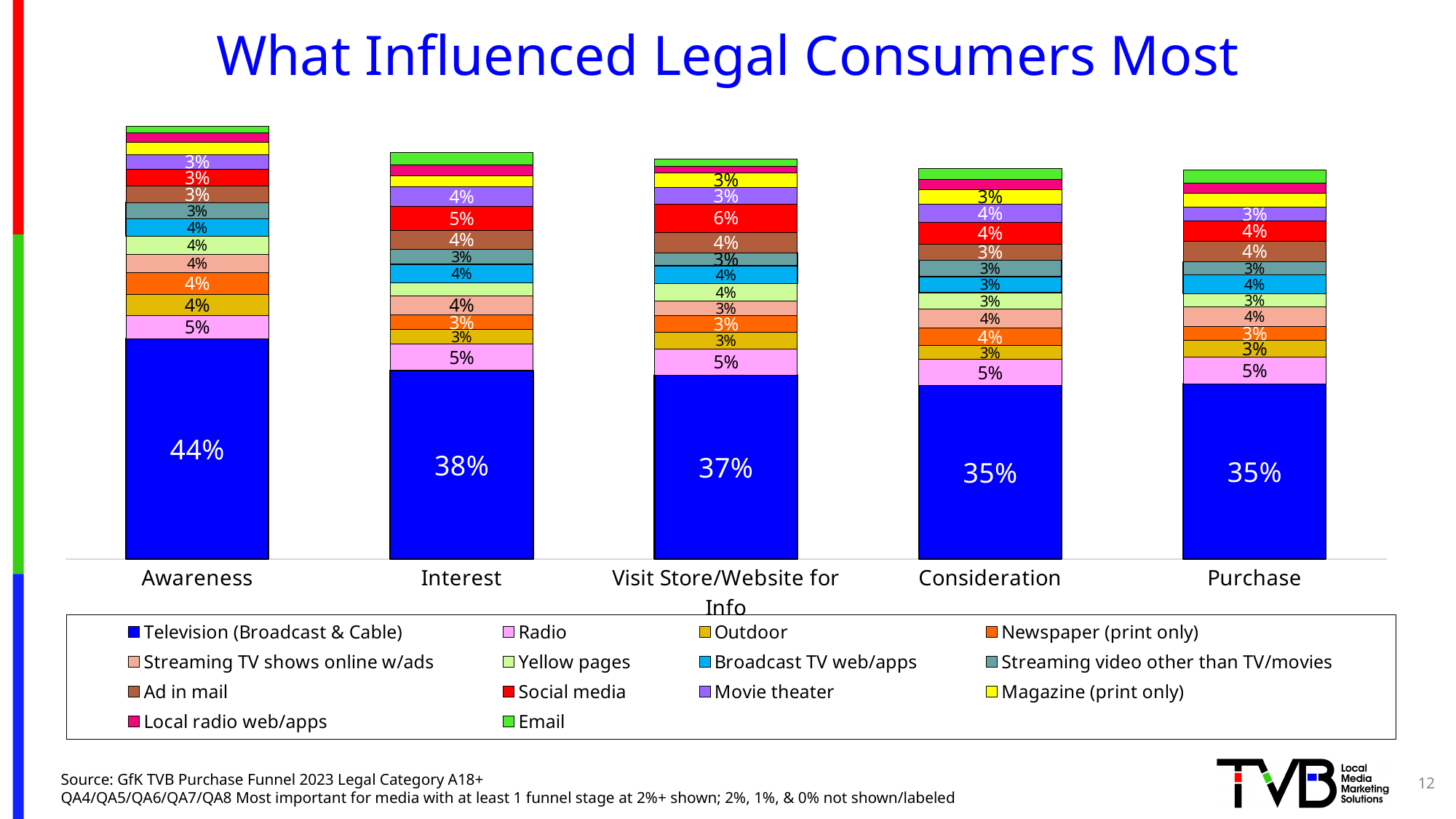
What is the Radio value at the Interest stage? 5% What percentage of legal consumers cited Television (Broadcast & Cable) as most influential at the Awareness stage? 44% What is the Television (Broadcast & Cable) value for the Purchase stage? 35% Which is larger: the Social media value at Interest or at Visit Store/Website for Info? Visit Store/Website for Info Does the Television (Broadcast & Cable) value rise or fall from Awareness to Purchase? Fall How many media types does the legend list? 14 How many funnel stages are shown on the x axis? 5 What is the title of the chart? What Influenced Legal Consumers Most What is the Social media value at the Visit Store/Website for Info stage? 6% At which funnel stage is the Television (Broadcast & Cable) value highest? Awareness What kind of chart is shown on the slide? Stacked bar chart What is the difference between the Television (Broadcast & Cable) values for Awareness and Interest? 6 percentage points